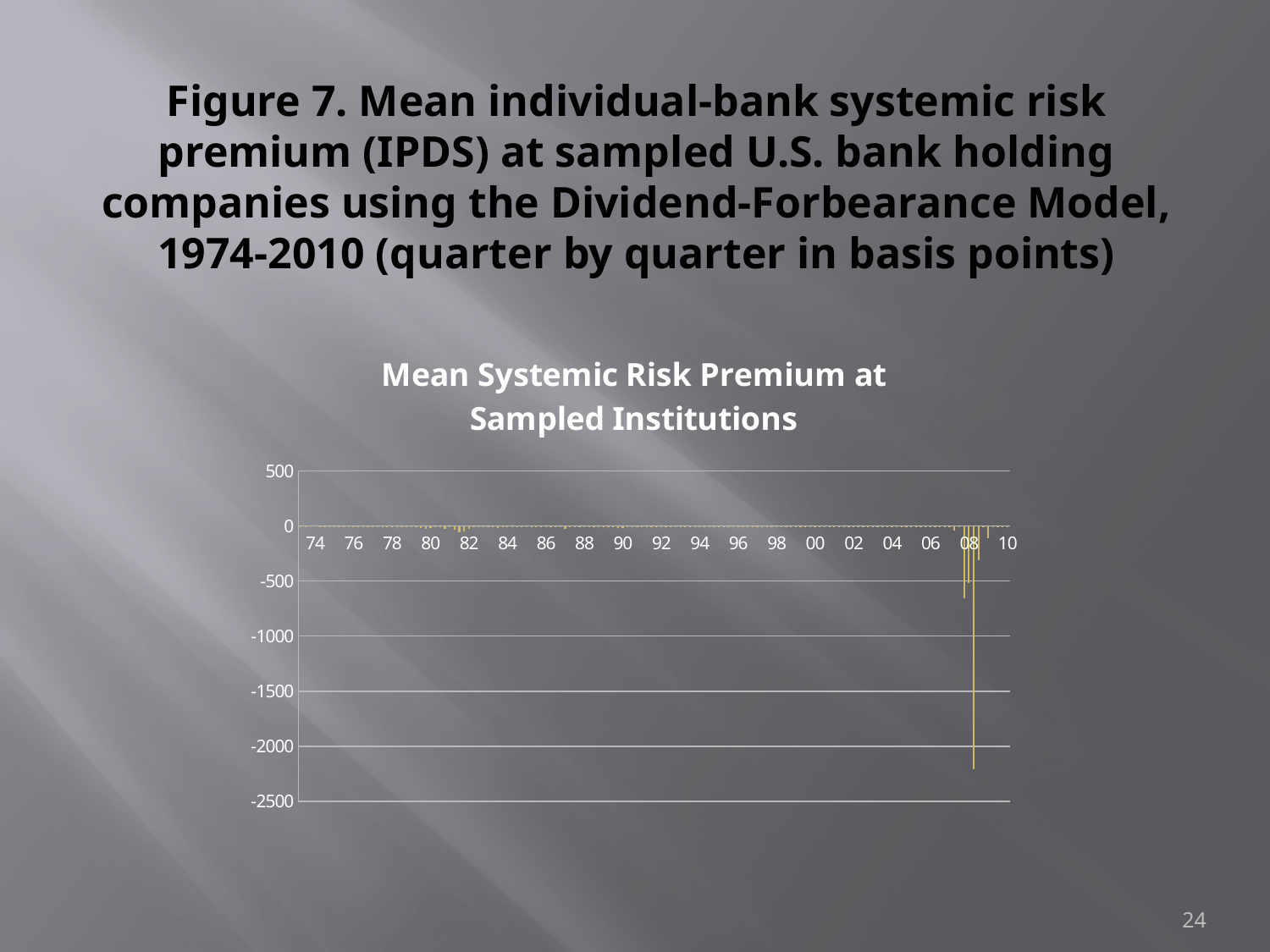
What kind of chart is shown on the slide? bar chart Near which labelled year on the x axis does the lowest value occur? 08 How many year labels are shown along the x axis? 19 What is the last year label on the x axis? 10 Is the deepest negative spike in the chart greater or less than -2000? less What is the title of the chart? Mean Systemic Risk Premium at Sampled Institutions Is the second-deepest negative spike, near 08, greater or less than -1000? greater What is the lowest value shown on the vertical axis? -2500 Is the deepest negative spike in the chart greater or less than -2500? greater What is the first year label on the x axis? 74 Do the values stay close to zero or vary widely between 1974 and 2006? close to zero What is the highest value shown on the vertical axis? 500